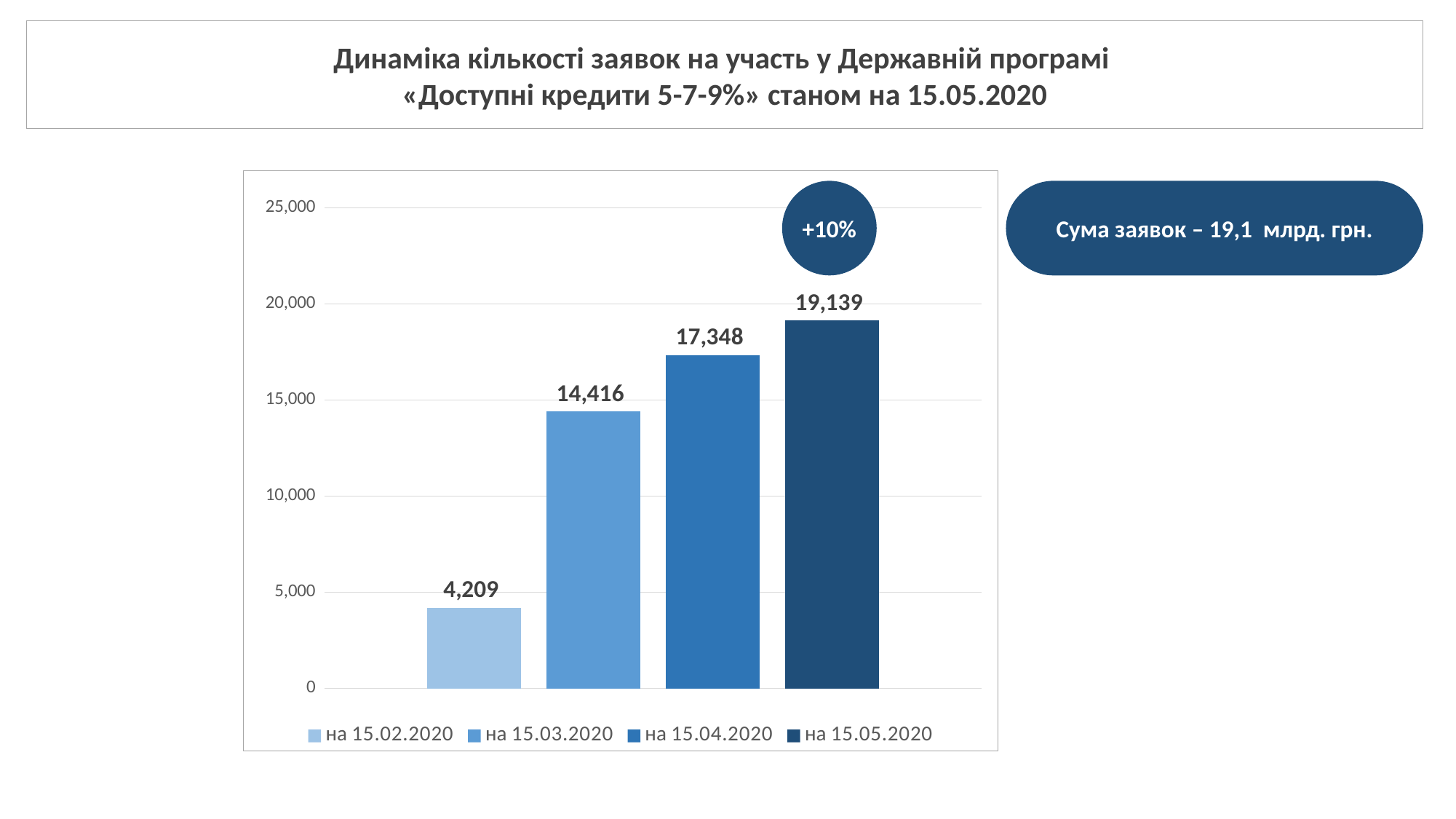
What kind of chart is shown on the slide? Bar chart What is the difference between the values for на 15.05.2020 and на 15.04.2020? 1,791 Which date has the lowest number of applications? на 15.02.2020 What value is shown for на 15.04.2020? 17,348 What value is shown for на 15.03.2020? 14,416 What is the difference between the values for на 15.03.2020 and на 15.02.2020? 10,207 How many bars are plotted in the chart? 4 Which date has the highest number of applications? на 15.05.2020 Which is larger, the value for на 15.03.2020 or the value for на 15.04.2020? на 15.04.2020 Do the values rise or fall from 15.02.2020 to 15.05.2020? Rise What is the number of applications as of 15.05.2020 (на 15.05.2020)? 19,139 What value is shown for на 15.02.2020? 4,209